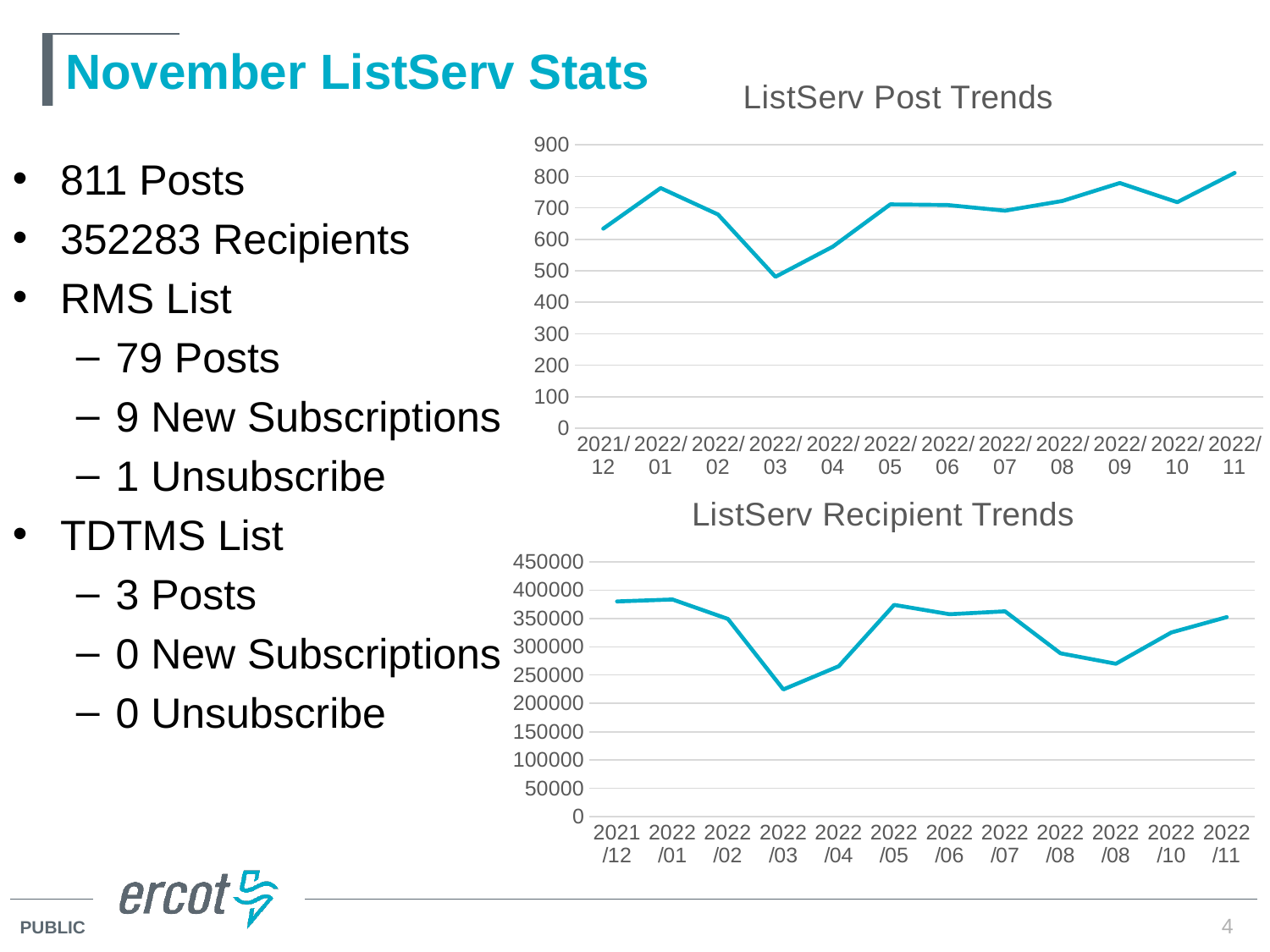
On the ListServ Recipient Trends chart, is the value for 2022/03 greater or less than 250000? less On the ListServ Post Trends chart, does the line rise or fall between 2022/01 and 2022/03? fall On the ListServ Post Trends chart, is the value for 2022/11 greater or less than 800? greater On the ListServ Post Trends chart, is the value for 2022/03 greater or less than 500? less On the ListServ Post Trends chart, which month has the highest value? 2022/11 On the ListServ Post Trends chart, which is larger, the value for 2022/03 or the value for 2022/09? 2022/09 How many data points are plotted on the ListServ Post Trends chart? 12 On the ListServ Recipient Trends chart, which month has the lowest value? 2022/03 On the ListServ Recipient Trends chart, which is larger, the value for 2022/03 or the value for 2022/05? 2022/05 What kind of chart is the ListServ Recipient Trends chart? line chart On the ListServ Post Trends chart, which month has the lowest value? 2022/03 What kind of chart is the ListServ Post Trends chart? line chart